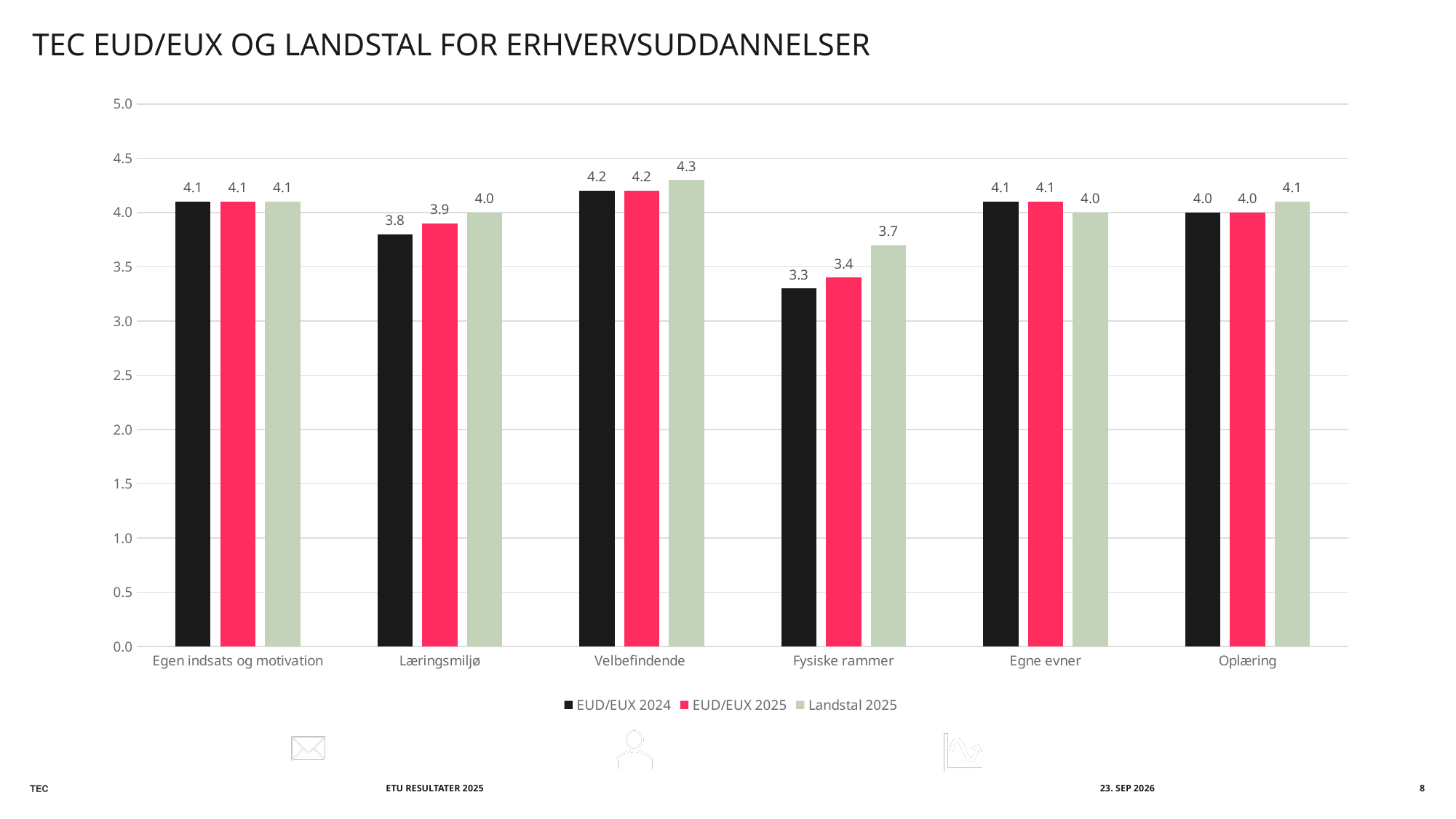
What is the Landstal 2025 value for Velbefindende? 4.3 What is the EUD/EUX 2025 value for Læringsmiljø? 3.9 For Egne evner, which is larger: the EUD/EUX 2025 value or the Landstal 2025 value? EUD/EUX 2025 What is the title of the slide? TEC EUD/EUX OG LANDSTAL FOR ERHVERVSUDDANNELSER Which series is shown in black? EUD/EUX 2024 Which category has the highest value in the Landstal 2025 series? Velbefindende What is the value for Fysiske rammer in the EUD/EUX 2024 series? 3.3 Which category has the lowest value in the EUD/EUX 2025 series? Fysiske rammer How many categories are shown on the x axis? 6 What kind of chart is shown on the slide? Bar chart What is the difference between the Landstal 2025 and EUD/EUX 2024 values for Fysiske rammer? 0.4 How many series does the legend list? 3